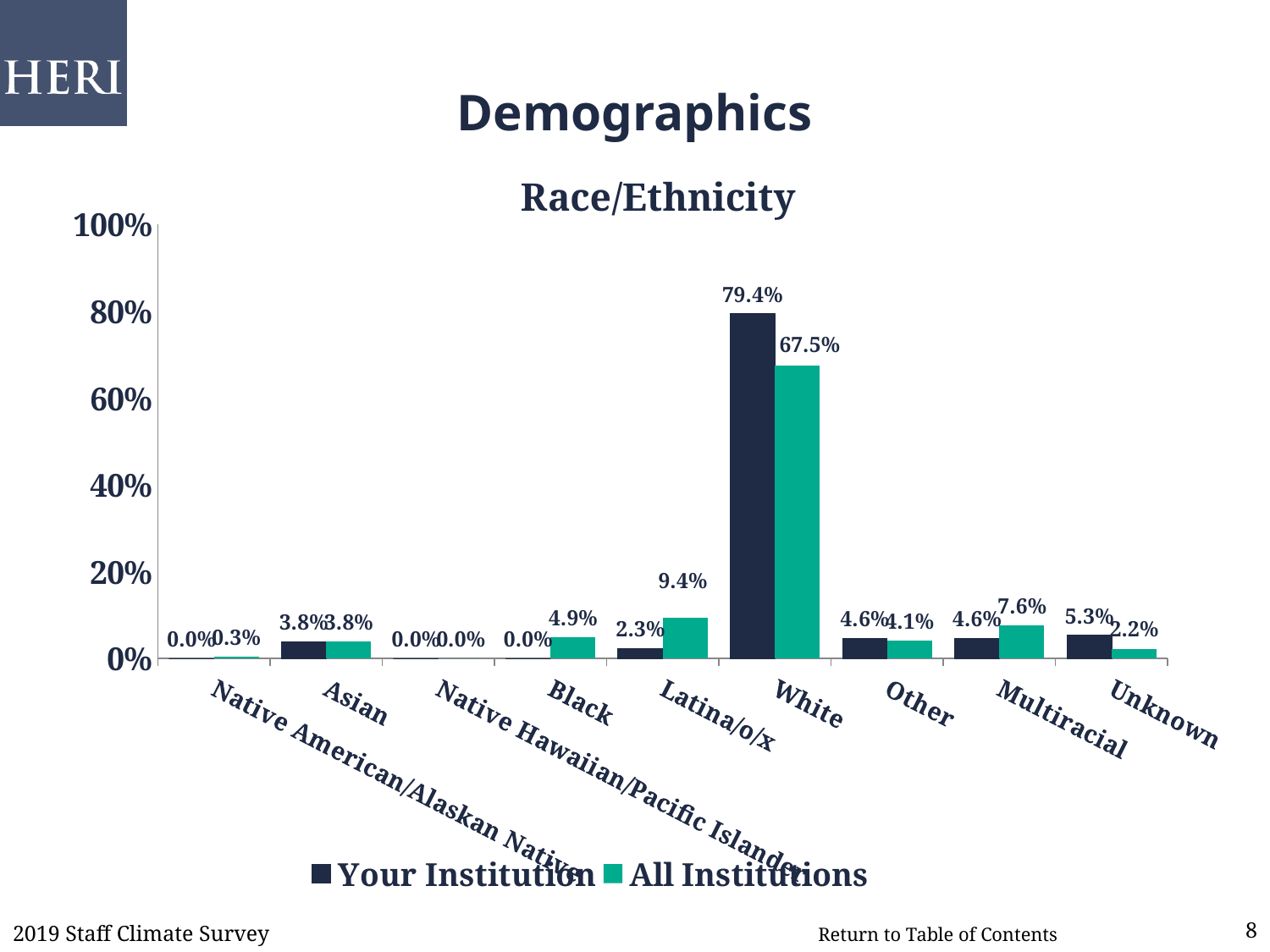
How many series does the legend list? 2 What is the difference between the Your Institution and All Institutions values for White? 11.9% Which is larger for Unknown: the Your Institution value or the All Institutions value? Your Institution What is the value for Black in the All Institutions series? 4.9% What is the value for White in the All Institutions series? 67.5% How many race/ethnicity categories are shown on the x axis? 9 Which is larger for Multiracial: the Your Institution value or the All Institutions value? All Institutions Which category has the highest value in the Your Institution series? White What is the difference between the All Institutions and Your Institution values for Latina/o/x? 7.1% What is the value for White in the Your Institution series? 79.4% What is the value for Latina/o/x in the All Institutions series? 9.4% What type of chart is shown on the slide? Bar chart